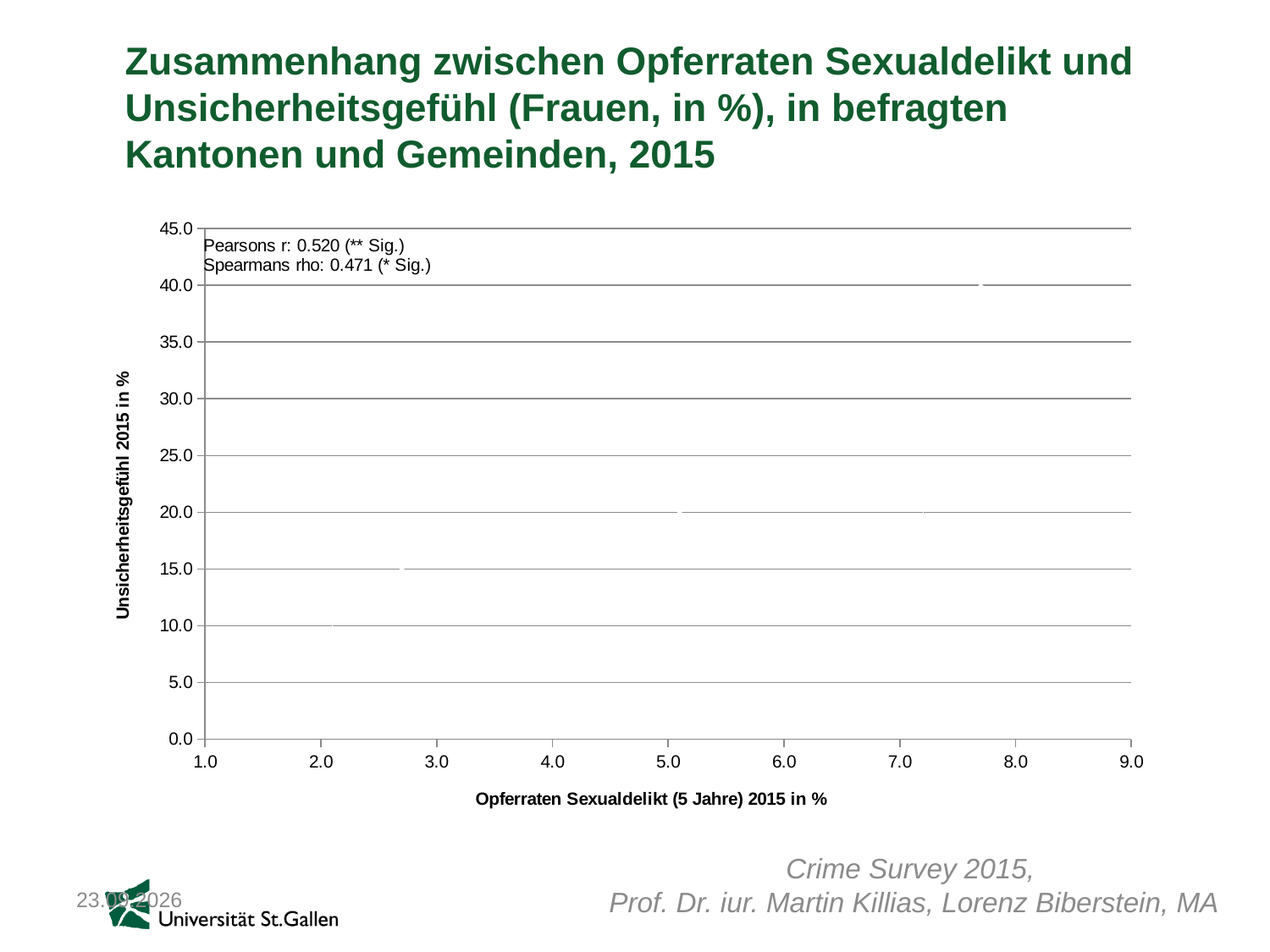
What Pearson's r value is printed on the chart? 0.520 What Spearman's rho value is printed on the chart? 0.471 What is the title of the x axis of the chart? Opferraten Sexualdelikt (5 Jahre) 2015 in % What is the highest value shown on the y axis of the chart? 45.0